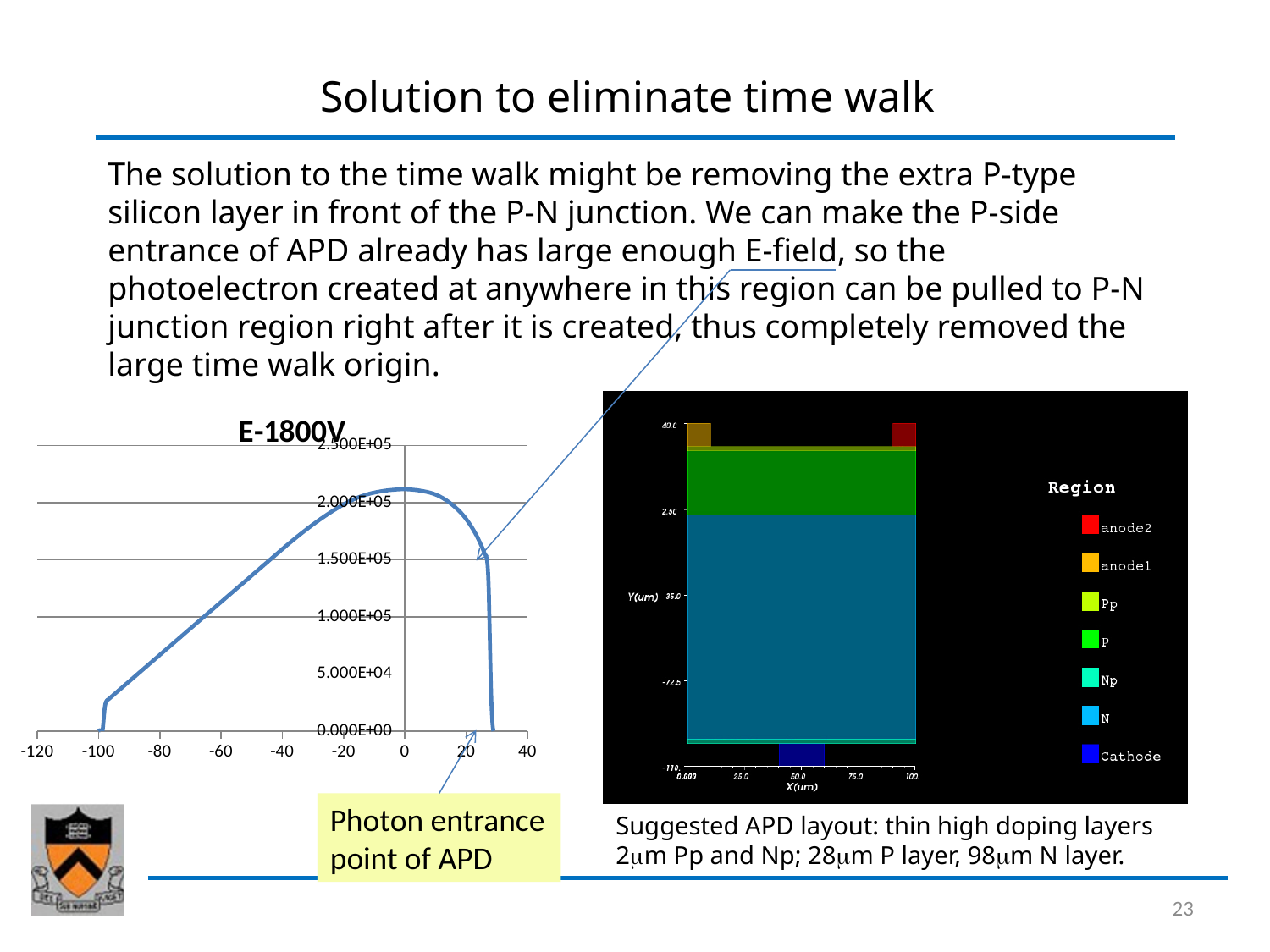
In the E-1800V chart, is the value at x = 0 greater or less than 1.500E+05? greater In the E-1800V chart, which has the larger value: x = -40 or x = -80? x = -40 In the E-1800V chart, does the curve rise or fall as x goes from 0 to 30? fall In the E-1800V chart, is the value at x = 20 greater or less than 1.500E+05? greater In the E-1800V chart, is the value at x = -60 greater or less than 1.000E+05? greater In the E-1800V chart, what is the highest tick label shown on the y axis? 2.500E+05 How many regions are listed in the legend of the APD layout diagram on the right of the slide? 7 In the E-1800V chart, does the curve rise or fall as x goes from -100 to 0? rise What kind of chart is the E-1800V chart on the left of the slide? line chart What is the title of the chart on the left of the slide? E-1800V